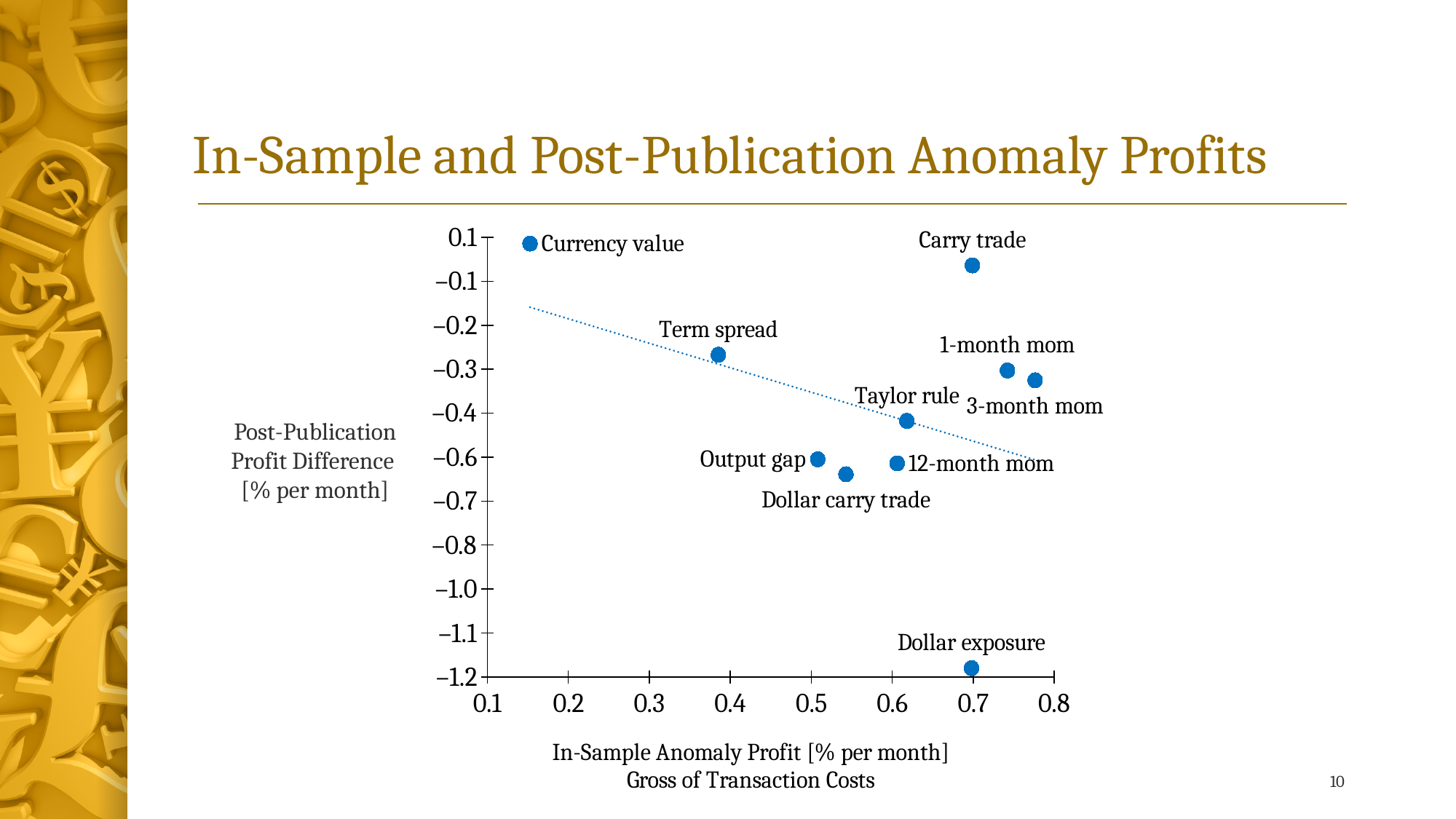
Does the dotted trend line rise or fall as in-sample anomaly profit increases? fall Is the post-publication profit difference for Term spread greater or less than -0.4? greater What is the title of the chart on the slide? In-Sample and Post-Publication Anomaly Profits Which anomaly has the lowest in-sample anomaly profit (furthest left on the x axis)? Currency value Is the in-sample anomaly profit for Currency value greater or less than 0.2? less Is the post-publication profit difference for Dollar exposure greater or less than -1.0? less What kind of chart is shown on the slide? scatter chart Which anomaly has the lowest post-publication profit difference? Dollar exposure How many labelled data points are plotted on the chart? 10 Which anomaly has the highest post-publication profit difference? Currency value Which has the higher post-publication profit difference, Carry trade or Term spread? Carry trade